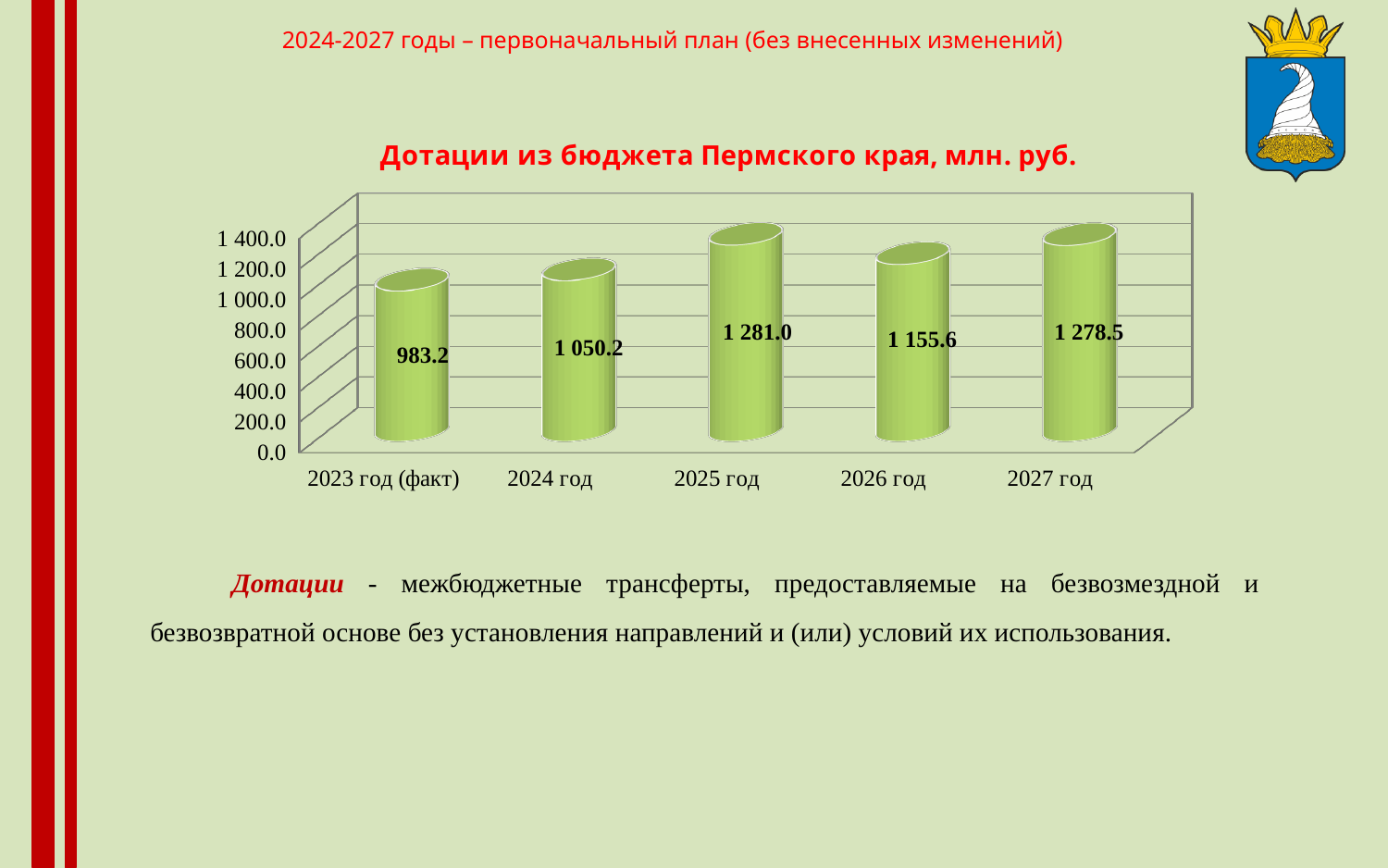
What is the value for 2027 год in the chart? 1 278.5 What kind of chart is shown on the slide? bar chart What is the difference between the values for 2025 год and 2024 год? 230.8 Which year has the highest value in the chart? 2025 год What is the value for 2025 год in the chart? 1 281.0 Which category has the lowest value in the chart? 2023 год (факт) What is the title of the chart? Дотации из бюджета Пермского края, млн. руб. Which is larger, the value for 2024 год or the value for 2026 год? 2026 год What is the difference between the values for 2027 год and 2026 год? 122.9 How many categories are shown in the chart? 5 Is the value for 2023 год (факт) greater or less than 1 000.0? less What is the value for 2023 год (факт) in the chart? 983.2